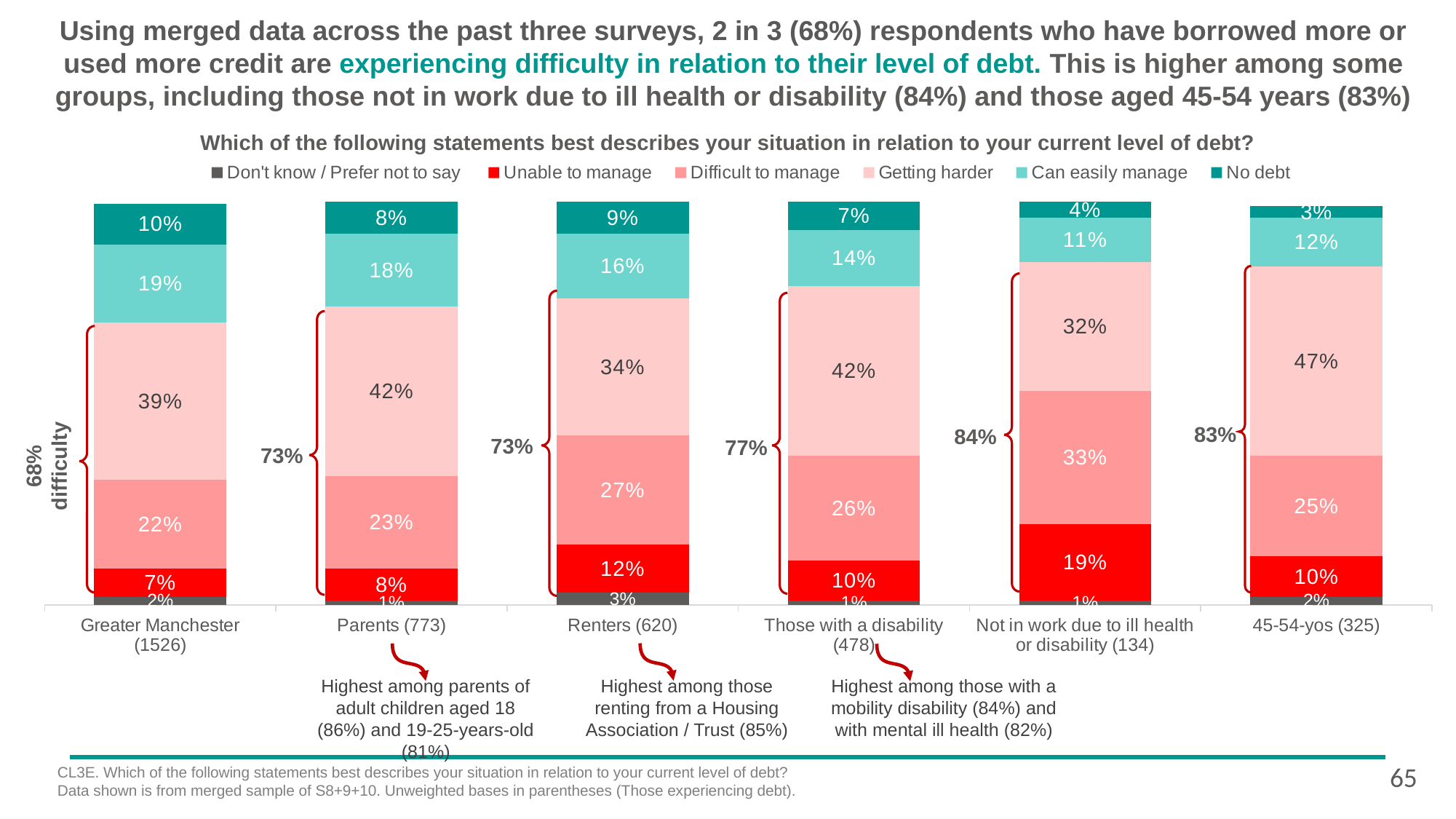
Which legend entry is shown in the darkest grey colour? Don't know / Prefer not to say Which is larger: the 'Can easily manage' percentage for Greater Manchester (1526) or for Those with a disability (478)? Greater Manchester (1526) What kind of chart is shown on the slide? Stacked bar chart What percentage of Renters (620) are 'Unable to manage'? 12% What is the difference between the 'Getting harder' percentages for Parents (773) and Renters (620)? 8% What percentage of Greater Manchester (1526) respondents have 'No debt'? 10% How many groups (bars) are shown on the chart? 6 What percentage of 45-54-yos (325) say their debt is 'Getting harder'? 47% Which group has the lowest 'No debt' percentage? 45-54-yos (325) How many series does the legend list? 6 What share of those 'Not in work due to ill health or disability (134)' are experiencing difficulty, according to the bracket label? 84% Which group has the highest 'Unable to manage' percentage? Not in work due to ill health or disability (134)